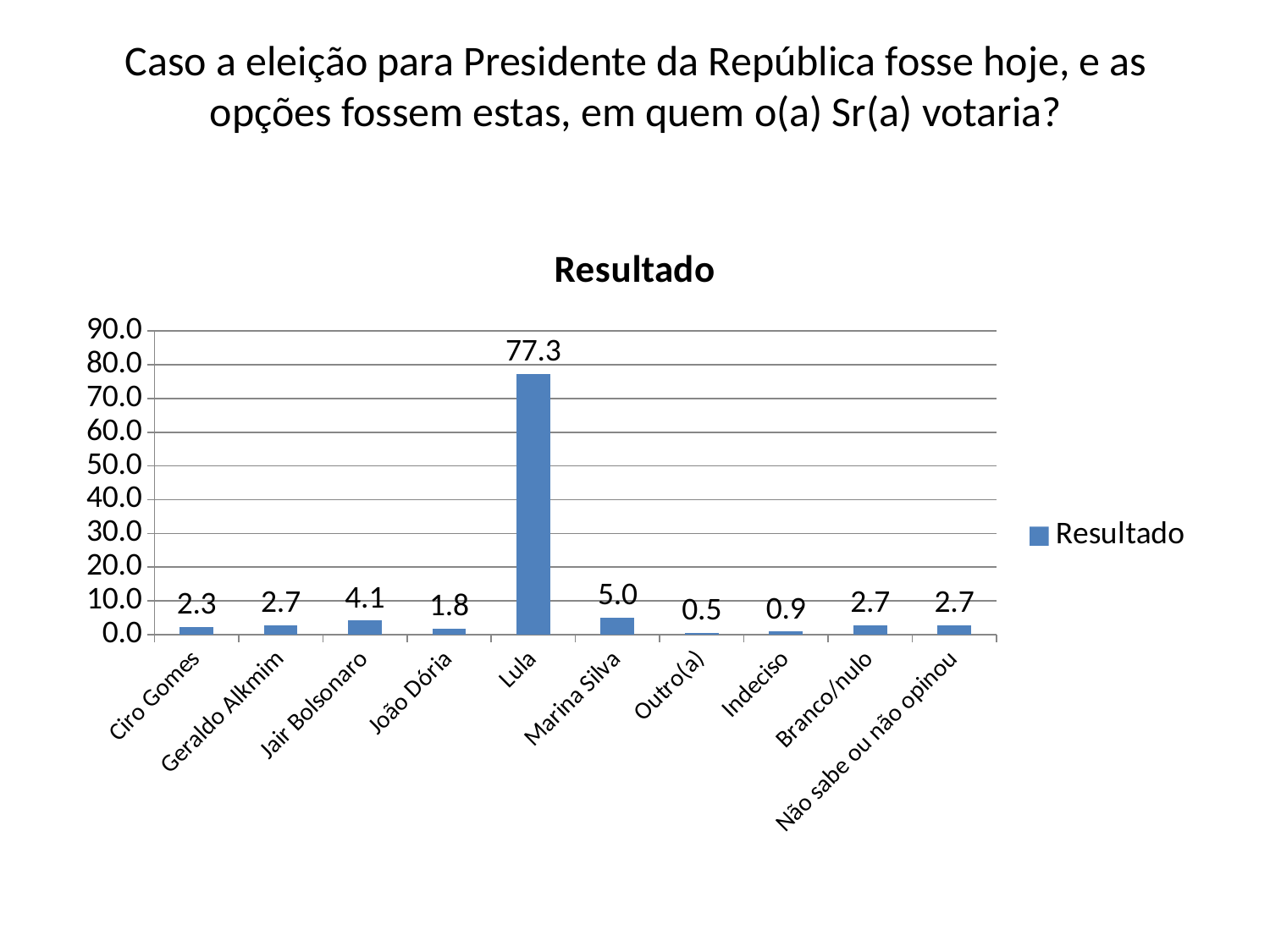
Which category has the lowest value? Outro(a) Is the value for Lula greater or less than 70.0? greater How many categories are shown on the x axis? 10 What is the value for Lula? 77.3 What is the value for Marina Silva? 5.0 What is the value for Outro(a)? 0.5 What is the value for Jair Bolsonaro? 4.1 What kind of chart is shown? bar chart Which is larger, the value for Ciro Gomes or the value for Geraldo Alkmim? Geraldo Alkmim Which category has the highest value? Lula What is the difference between the values for Lula and Marina Silva? 72.3 How many series does the legend list? 1